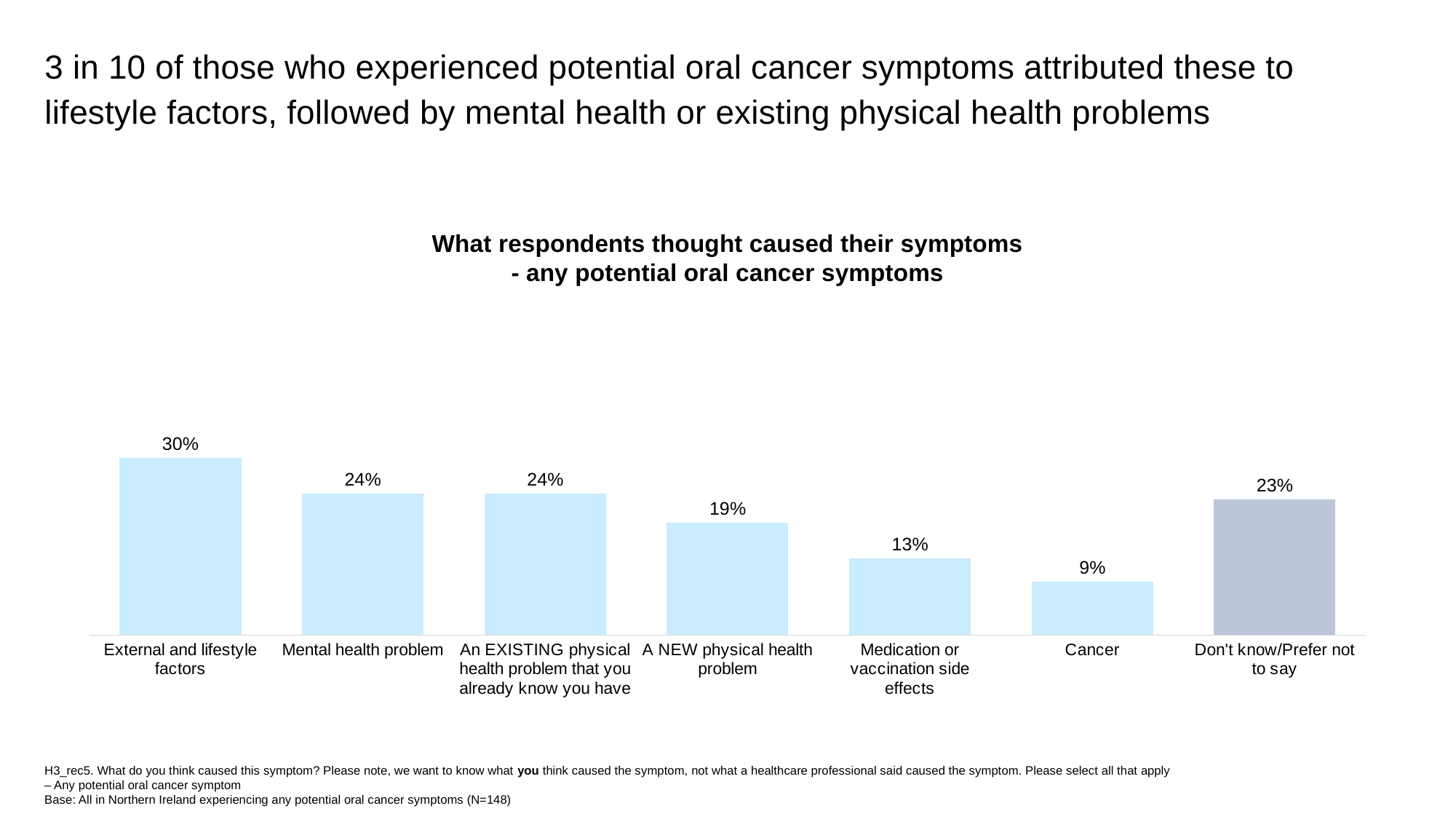
How many categories are shown in the chart? 7 What is the title of the chart? What respondents thought caused their symptoms - any potential oral cancer symptoms Which is larger: the value for A NEW physical health problem or the value for Medication or vaccination side effects? A NEW physical health problem What is the difference between the value for External and lifestyle factors and the value for Cancer? 21% What kind of chart is shown on the slide? Bar chart Which category has the lowest value? Cancer What percentage of respondents answered Don't know/Prefer not to say? 23% What is the difference between the value for Mental health problem and the value for A NEW physical health problem? 5% What percentage of respondents attributed their symptoms to external and lifestyle factors? 30% What is the value for Medication or vaccination side effects? 13% What is the value for Cancer? 9% Which category has the highest value? External and lifestyle factors